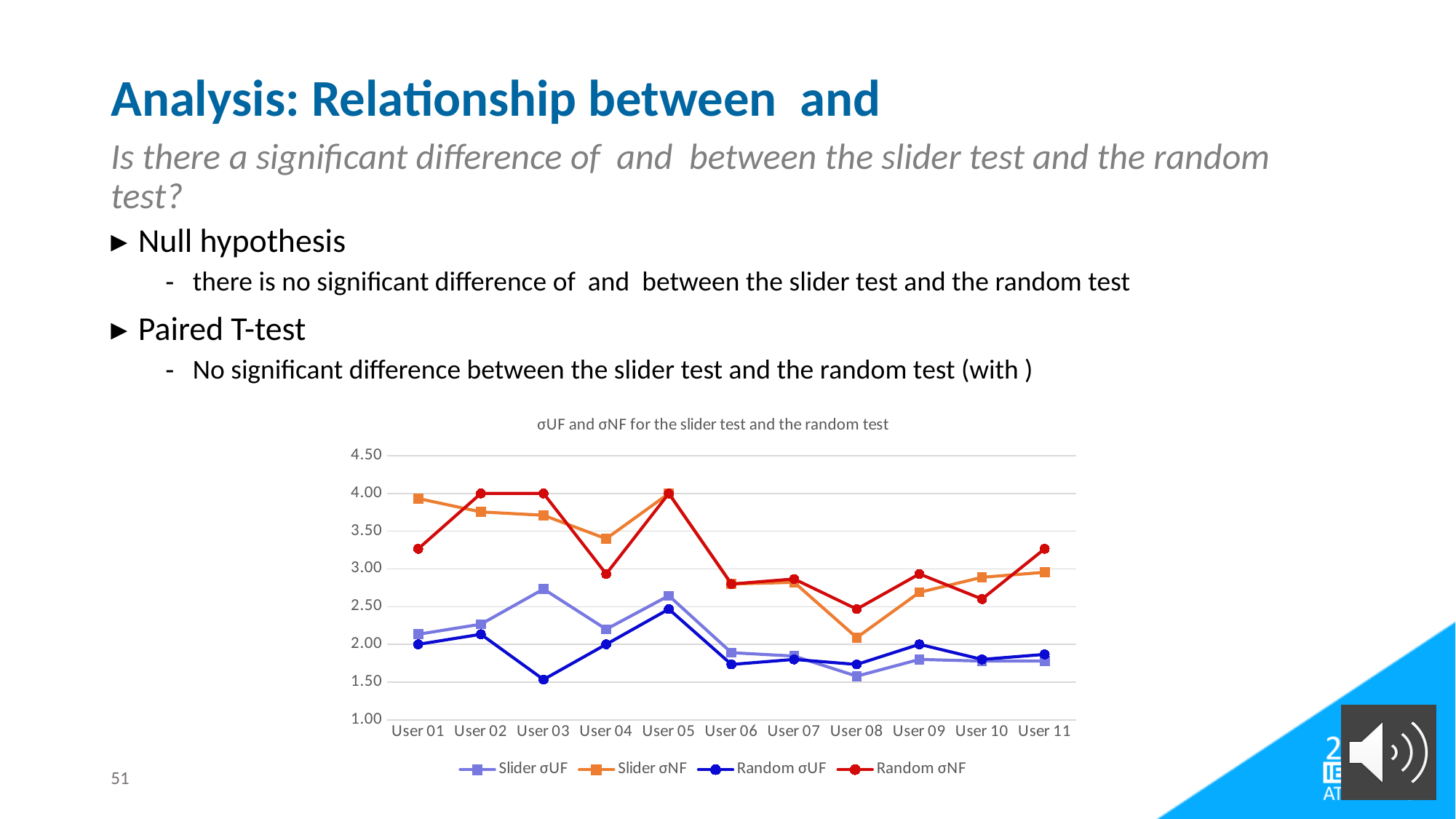
What is the title of the chart? σUF and σNF for the slider test and the random test Is the value of Slider σNF for User 08 greater or less than 2.50? less How many series does the chart legend list? 4 For User 03, which series has the higher value: Slider σUF or Random σUF? Slider σUF For User 08, which series has the higher value: Random σNF or Slider σNF? Random σNF What is the value of Random σNF for User 02? 4.00 Is the value of Slider σUF for User 03 greater or less than 2.50? greater What is the value of Random σUF for User 01? 2.00 Is the value of Random σUF for User 03 greater or less than 2.00? less Which user has the lowest Random σUF value? User 03 How many users are shown along the x axis of the chart? 11 What type of chart is shown on the slide? line chart